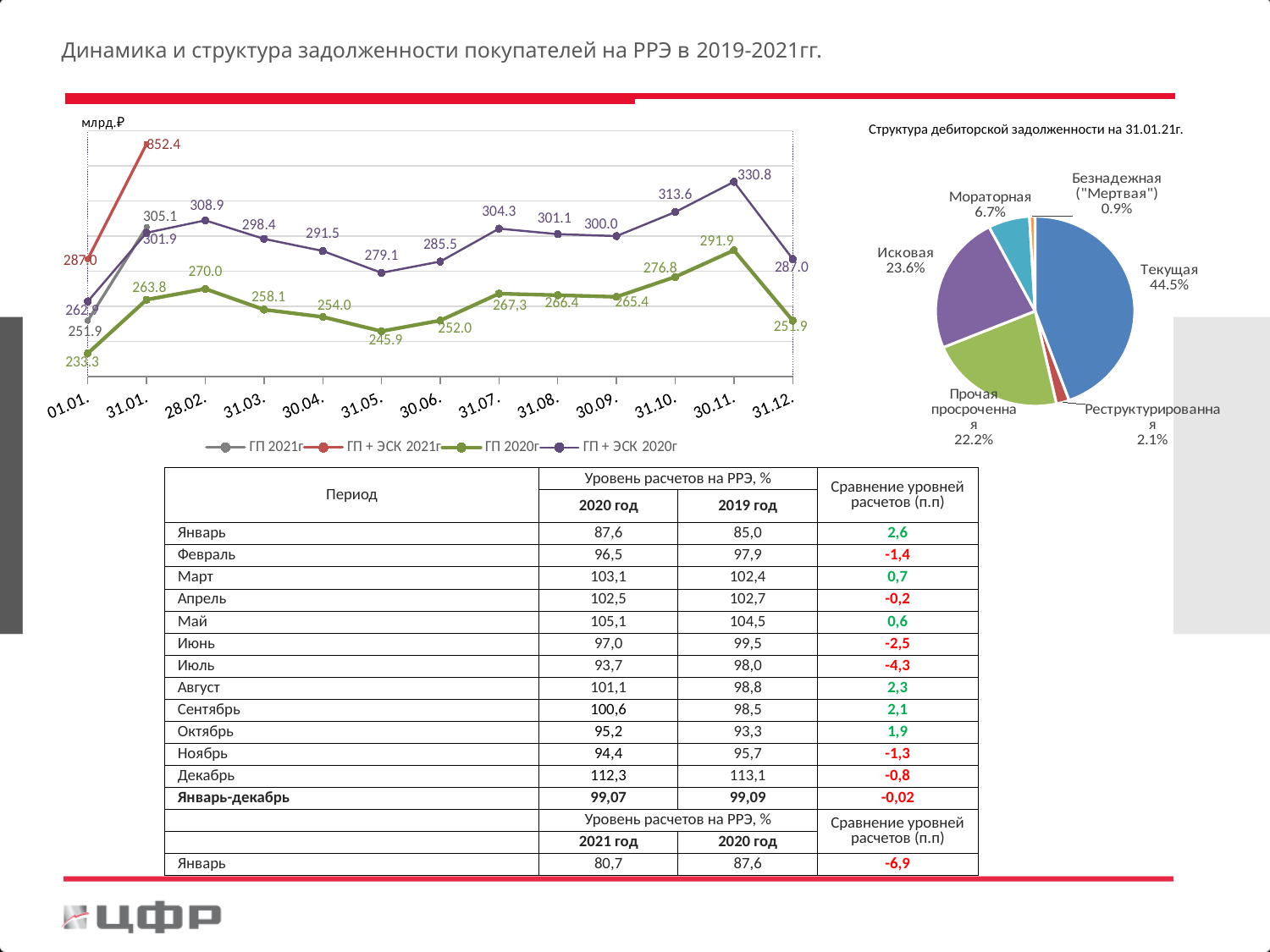
On the line chart, what is the value of ГП 2020г at 30.11.? 291.9 On the line chart, at which date does ГП + ЭСК 2020г reach its highest value? 30.11. On the pie chart 'Структура дебиторской задолженности на 31.01.21г.', what share does Текущая have? 44.5% On the pie chart 'Структура дебиторской задолженности на 31.01.21г.', which category has the smallest share? Безнадежная ("Мертвая") On the pie chart 'Структура дебиторской задолженности на 31.01.21г.', which is larger: Исковая or Прочая просроченная? Исковая How many dates are shown on the x axis of the line chart? 13 What kind of chart is the chart on the left of the slide? Line chart On the line chart, what is the value of ГП + ЭСК 2020г at 30.11.? 330.8 On the line chart, what is the value of ГП + ЭСК 2021г at 31.01.? 352.4 On the line chart, at which date is ГП 2020г at its lowest value? 01.01. How many series does the legend of the line chart list? 4 On the line chart, what is the difference between ГП + ЭСК 2020г and ГП 2020г at 30.11.? 38.9